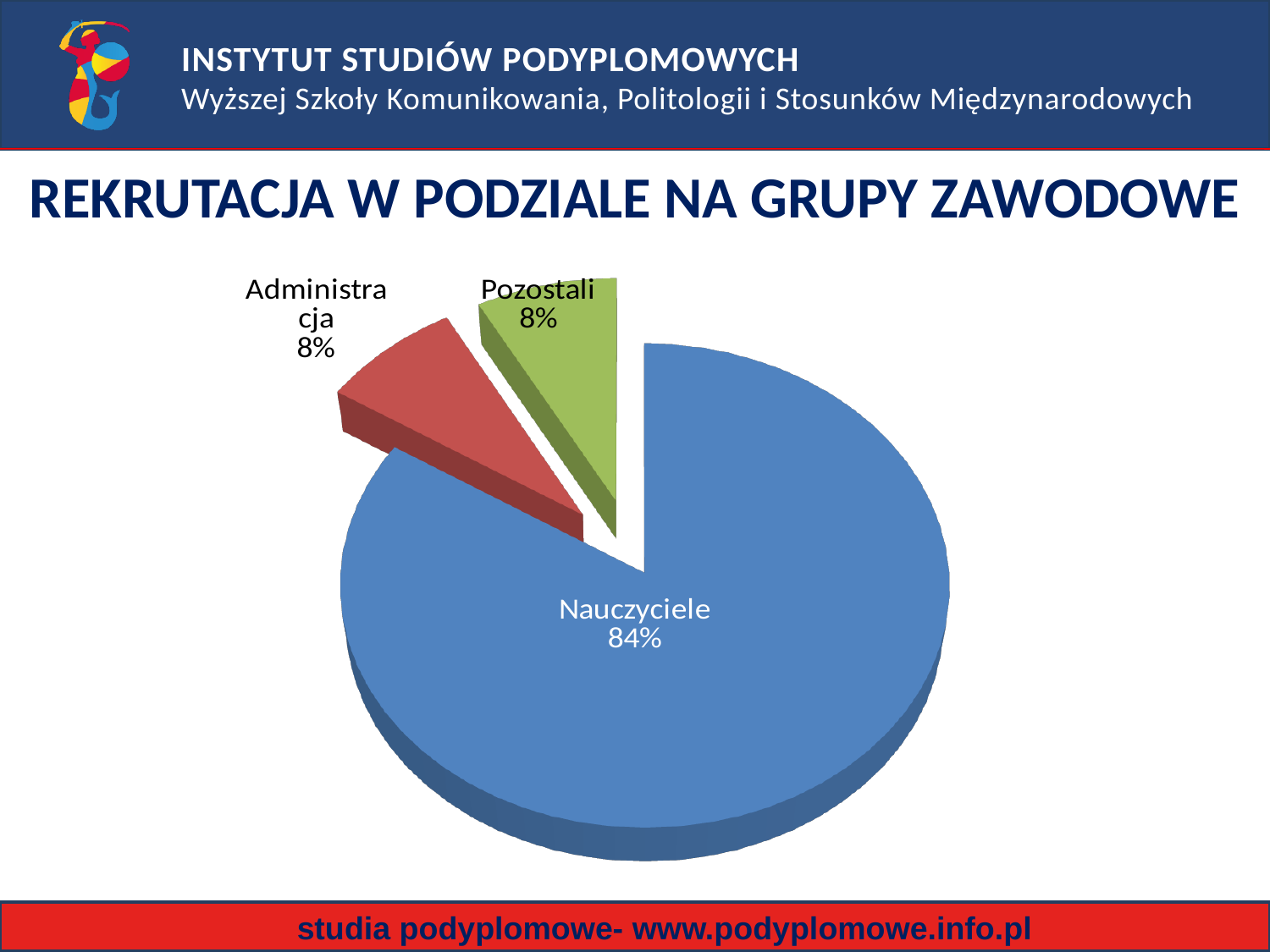
What share of the pie does Administracja have? 8% What colour is the Nauczyciele slice? blue Which is larger, the share for Nauczyciele or the share for Pozostali? Nauczyciele How many slices does the pie chart have? 3 What is the combined share of Administracja and Pozostali? 16% What is the difference in percentage points between Nauczyciele and Administracja? 76 What share of the pie does Pozostali have? 8% What is the title of the slide containing the chart? REKRUTACJA W PODZIALE NA GRUPY ZAWODOWE What kind of chart is shown on the slide? pie chart Which group has the largest slice of the pie? Nauczyciele What share of the pie does Nauczyciele have? 84%